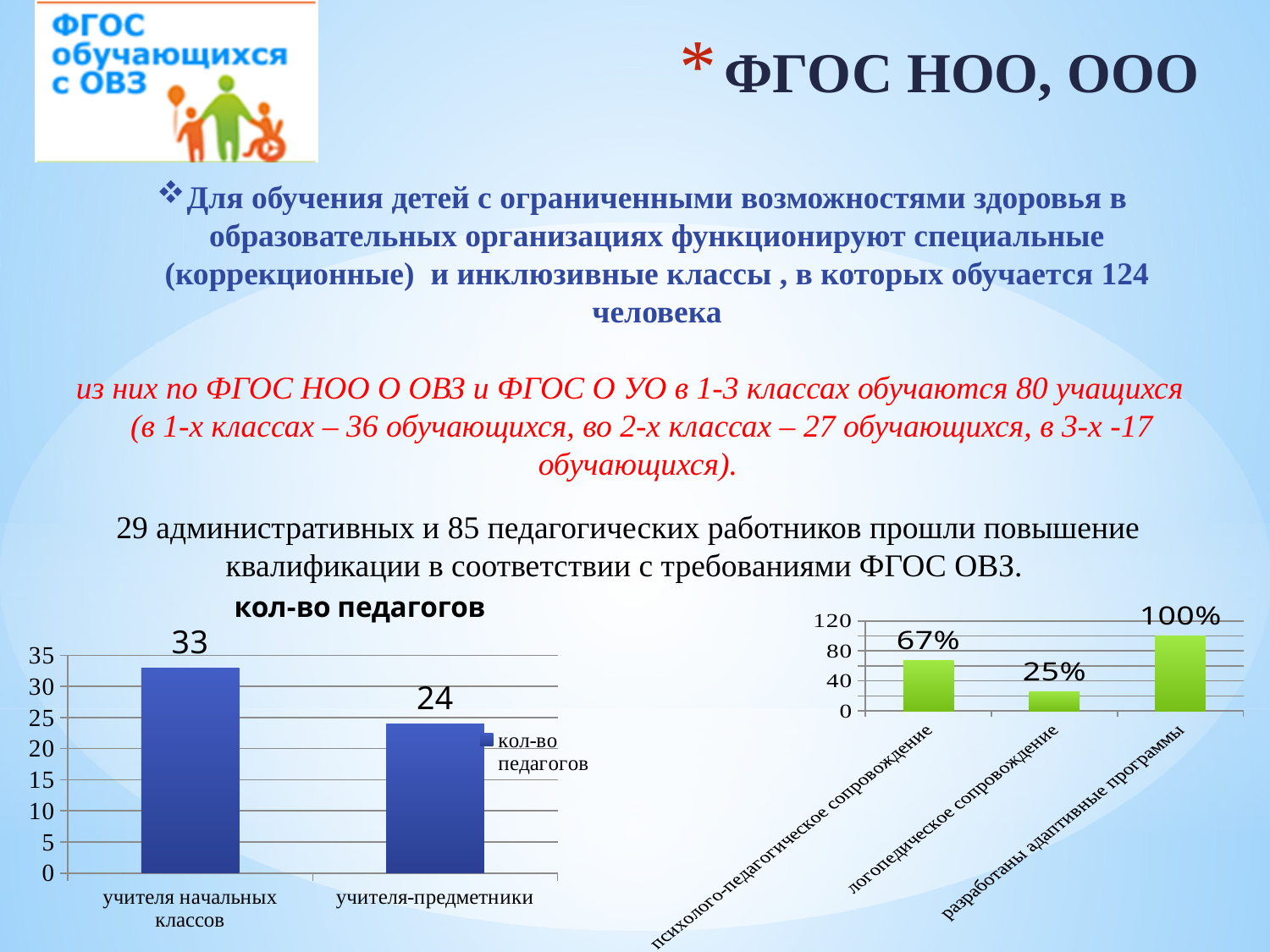
In the chart on the right of the slide, how many bars are shown? 3 In the chart titled "кол-во педагогов", how many categories are shown? 2 In the chart on the right of the slide, what is the value for психолого-педагогическое сопровождение? 67% In the chart titled "кол-во педагогов", what kind of chart is it? bar chart In the chart on the right of the slide, which category has the highest value? разработаны адаптивные программы In the chart on the right of the slide, which category has the lowest value? логопедическое сопровождение In the chart titled "кол-во педагогов", what is the value for учителя-предметники? 24 In the chart titled "кол-во педагогов", what entry does the legend list? кол-во педагогов In the chart titled "кол-во педагогов", which category has the highest value? учителя начальных классов In the chart titled "кол-во педагогов", what is the difference between the values for учителя начальных классов and учителя-предметники? 9 In the chart on the right of the slide, what is the value for логопедическое сопровождение? 25% In the chart titled "кол-во педагогов", what is the value for учителя начальных классов? 33